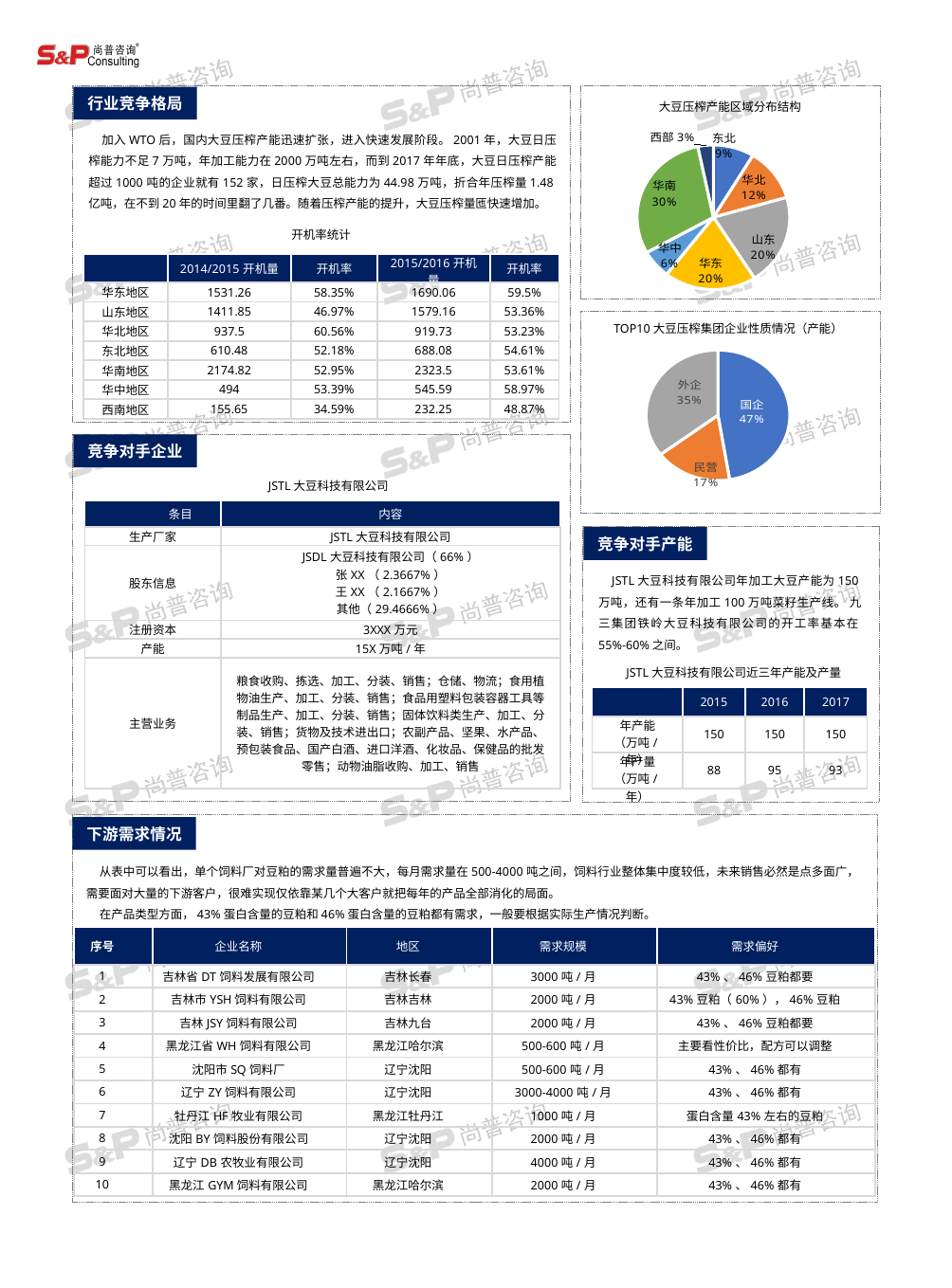
In the chart titled 大豆压榨产能区域分布结构, what is the difference between the shares of 华南 and 东北? 21% In the chart titled 大豆压榨产能区域分布结构, what share does 华南 hold? 30% In the chart titled TOP10 大豆压榨集团企业性质情况（产能）, what share does 国企 hold? 47% In the chart titled 大豆压榨产能区域分布结构, which is larger, the share of 华中 or the share of 东北? 东北 In the chart titled 大豆压榨产能区域分布结构, how many regions are shown? 7 In the chart titled 大豆压榨产能区域分布结构, which region has the largest share? 华南 In the chart titled 大豆压榨产能区域分布结构, what share does 华北 hold? 12% In the chart titled TOP10 大豆压榨集团企业性质情况（产能）, which category has the smallest share? 民营 In the chart titled TOP10 大豆压榨集团企业性质情况（产能）, how many categories are shown? 3 In the chart titled 大豆压榨产能区域分布结构, which region has the smallest share? 西部 In the chart titled TOP10 大豆压榨集团企业性质情况（产能）, what is the difference between the shares of 国企 and 外企? 12% What kind of chart is the chart titled TOP10 大豆压榨集团企业性质情况（产能）? pie chart